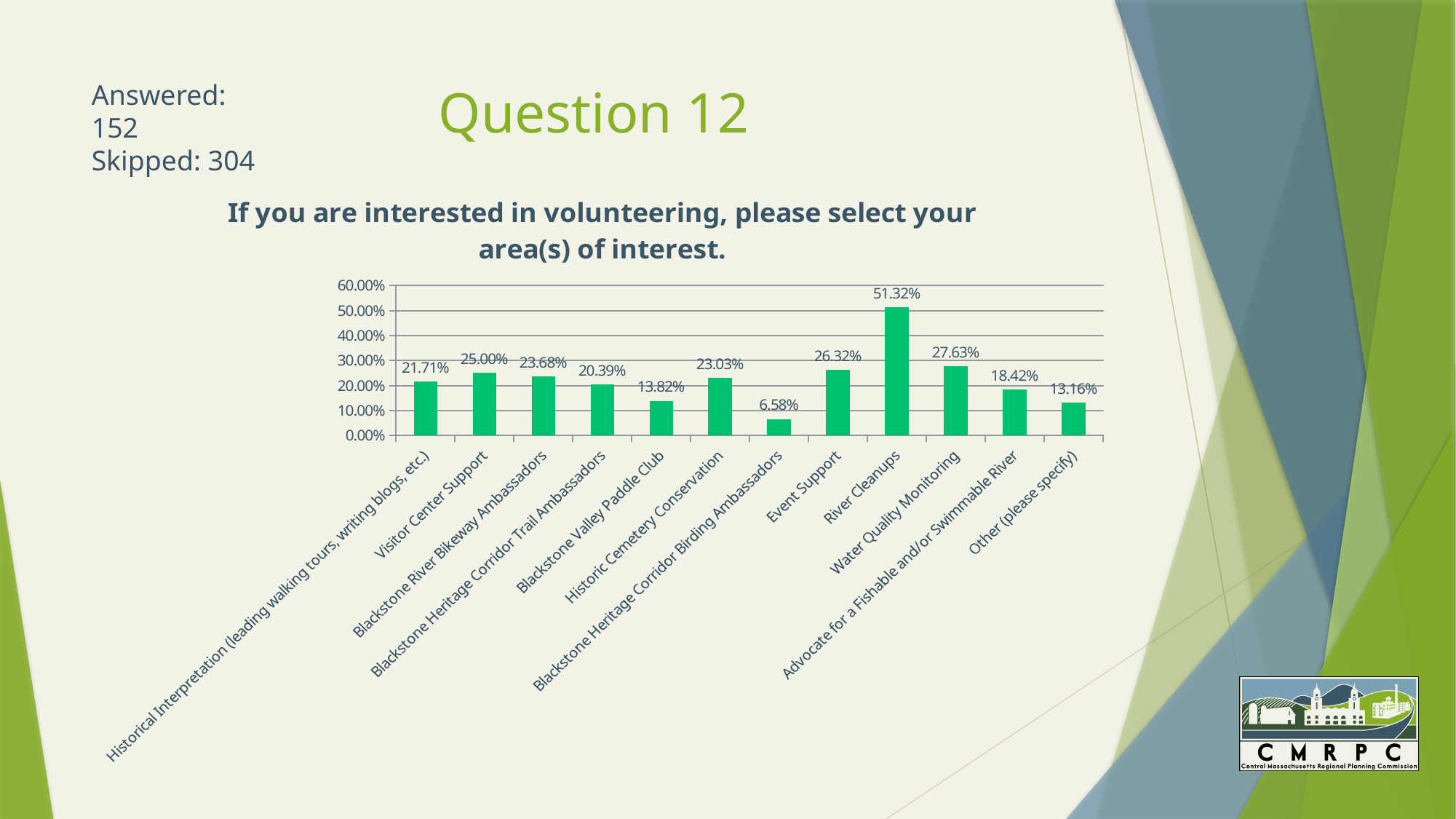
What is the value shown for Other (please specify)? 13.16% What type of chart is used on this slide? bar chart What is the value shown for Blackstone Valley Paddle Club? 13.82% Which has a higher percentage, Visitor Center Support or Historical Interpretation (leading walking tours, writing blogs, etc.)? Visitor Center Support Which area of interest has the lowest percentage? Blackstone Heritage Corridor Birding Ambassadors Which area of interest has the highest percentage? River Cleanups What is the difference between the percentages for River Cleanups and Event Support? 25.00% Is the value for Advocate for a Fishable and/or Swimmable River greater or less than 20.00%? less How many areas of interest are shown on the chart? 12 What is the title of the chart? If you are interested in volunteering, please select your area(s) of interest. What percentage of respondents selected River Cleanups as an area of interest? 51.32% What percentage is shown for Water Quality Monitoring? 27.63%